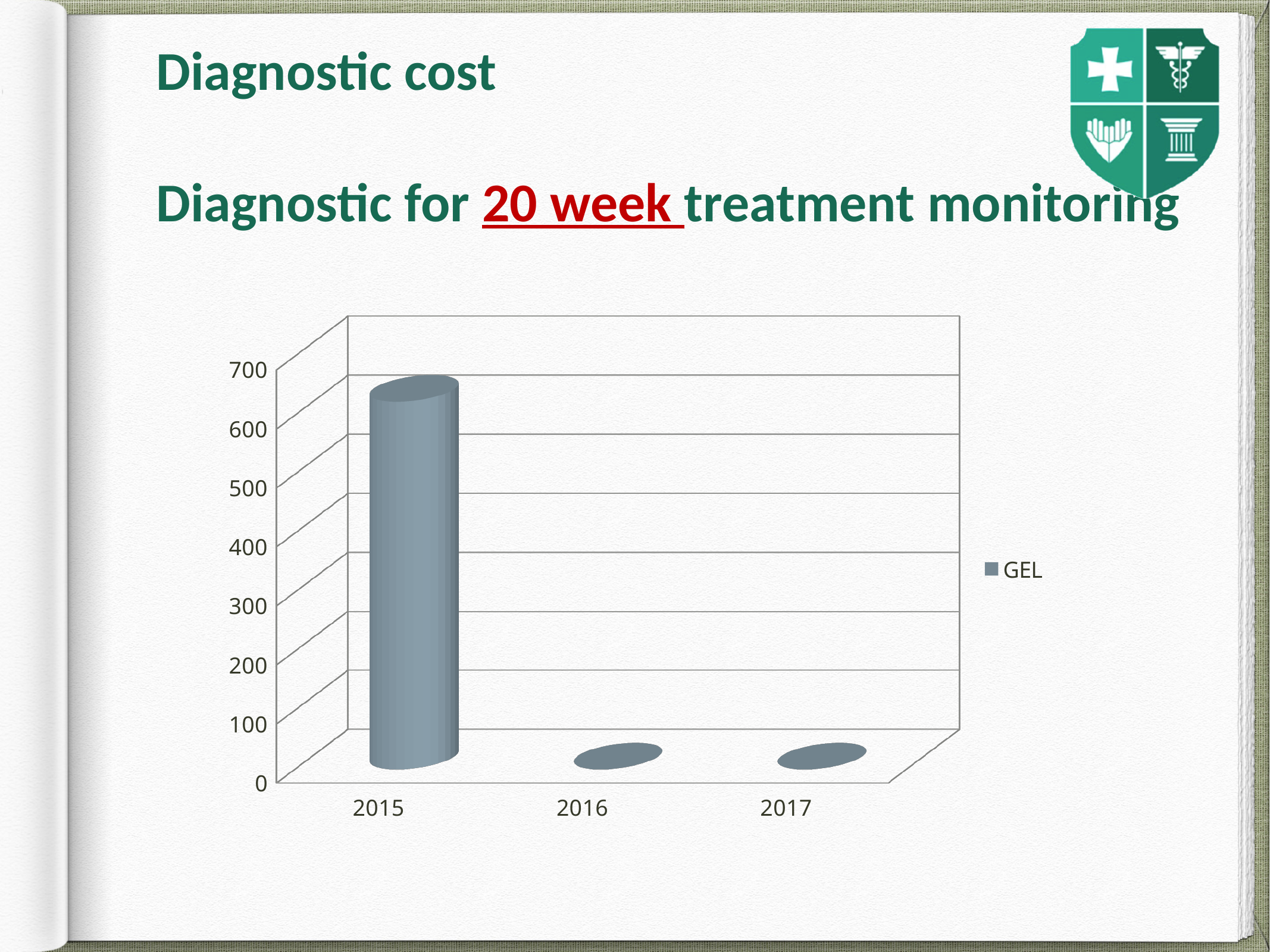
Is the value for 2015 greater or less than 700? less Is the value for 2016 greater or less than 100? less What is the name of the series shown in the chart legend? GEL Which year has the highest value in the chart? 2015 Which is larger, the value for 2015 or the value for 2016? 2015 What kind of chart is shown on the slide? bar chart Do the values rise or fall from 2015 to 2017? fall How many categories are shown on the x axis of the chart? 3 How many series does the chart legend list? 1 Which is larger, the value for 2017 or the value for 2015? 2015 Is the value for 2017 greater or less than 100? less